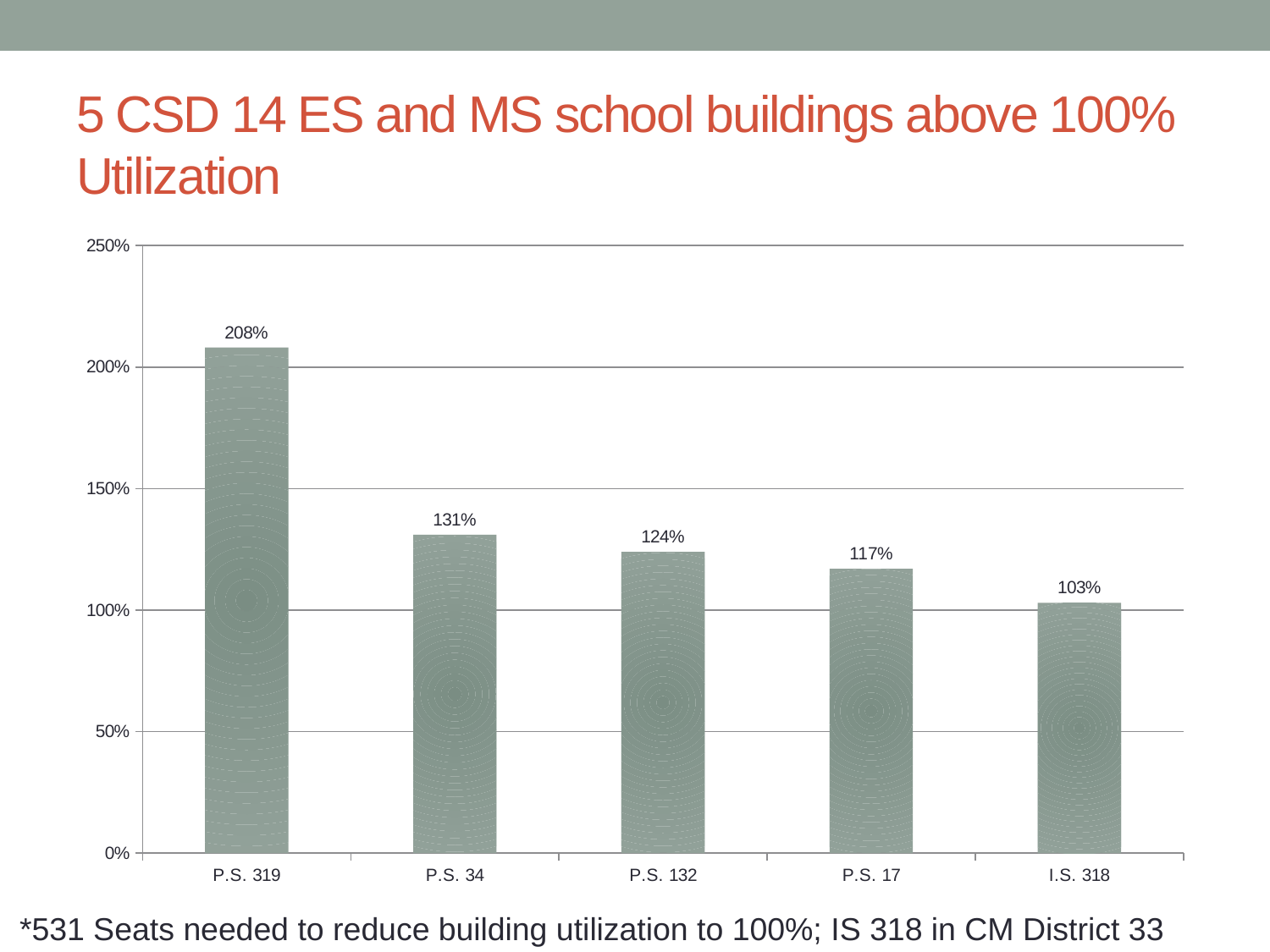
What is the utilization value for P.S. 132? 124% Which school building has the lowest utilization? I.S. 318 How many school buildings are shown in the chart? 5 What is the utilization value for P.S. 319? 208% Which school building has the highest utilization? P.S. 319 Do the values rise or fall from left to right across the x axis? fall Which has a higher utilization, P.S. 34 or P.S. 17? P.S. 34 What kind of chart is shown on the slide? bar chart What is the difference in utilization between P.S. 319 and P.S. 34? 77% Is the value for P.S. 132 greater or less than 150%? less What is the difference in utilization between P.S. 17 and I.S. 318? 14% What is the utilization value for I.S. 318? 103%